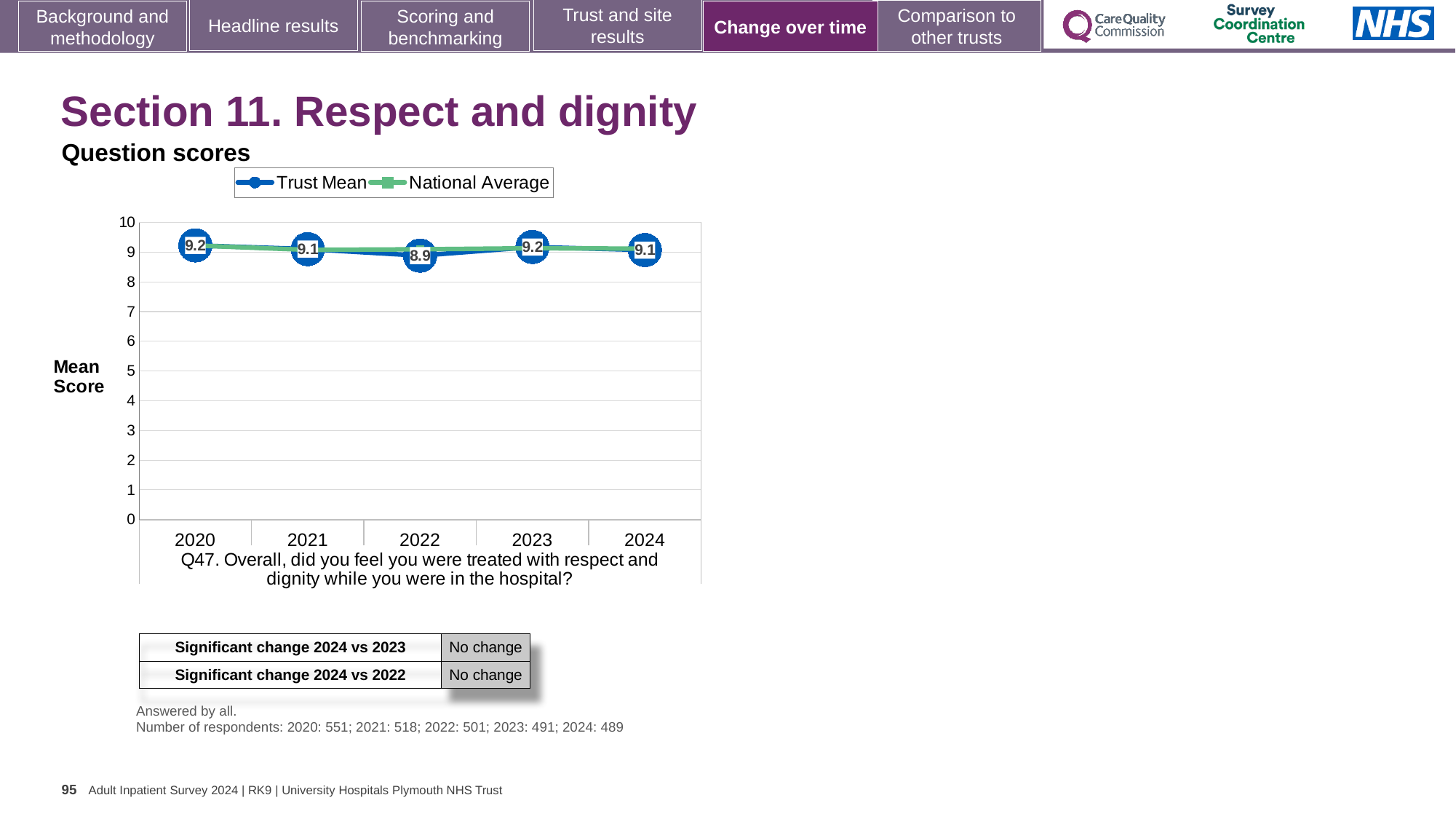
What is the Trust Mean score for 2020? 9.2 Did the Trust Mean score rise or fall from 2023 to 2024? Fall In which year is the Trust Mean score lowest? 2022 What are the two series named in the legend? Trust Mean and National Average What is the Trust Mean score for 2024? 9.1 What type of chart is shown on the slide? Line chart Is the National Average value for 2022 greater or less than 8? greater What is the difference between the Trust Mean scores for 2023 and 2022? 0.3 Which year has the larger Trust Mean score, 2022 or 2023? 2023 How many years are plotted on the x axis? 5 How many series does the legend list? 2 What is the Trust Mean score for 2022? 8.9